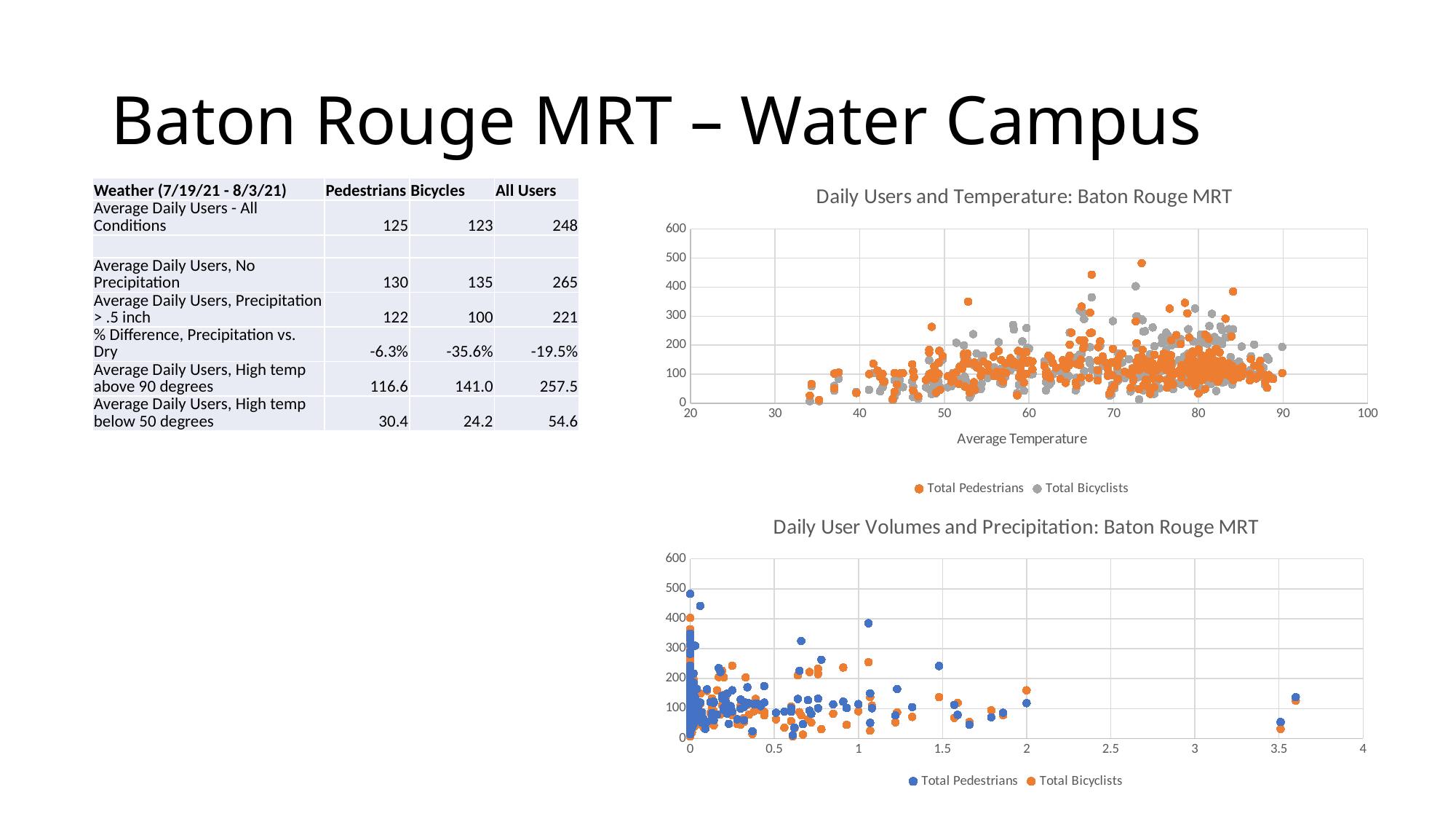
What kind of chart is the top chart titled 'Daily Users and Temperature: Baton Rouge MRT'? Scatter chart In the top chart 'Daily Users and Temperature', what is the title of the horizontal axis? Average Temperature In the top chart 'Daily Users and Temperature', what are the two series named in the legend? Total Pedestrians and Total Bicyclists In the top chart 'Daily Users and Temperature', is the highest Total Pedestrians point greater or less than 400? greater In the bottom chart 'Daily User Volumes and Precipitation', how many series does the legend list? 2 In the bottom chart 'Daily User Volumes and Precipitation', what colour are the Total Bicyclists points? Orange In the bottom chart 'Daily User Volumes and Precipitation', which series contains the single highest point? Total Pedestrians What kind of chart is the bottom chart titled 'Daily User Volumes and Precipitation: Baton Rouge MRT'? Scatter chart In the top chart 'Daily Users and Temperature', which series contains the single highest point? Total Pedestrians In the top chart 'Daily Users and Temperature', how many series does the legend list? 2 In the bottom chart 'Daily User Volumes and Precipitation', are the points plotted at a precipitation of 3.5 greater or less than 100? less